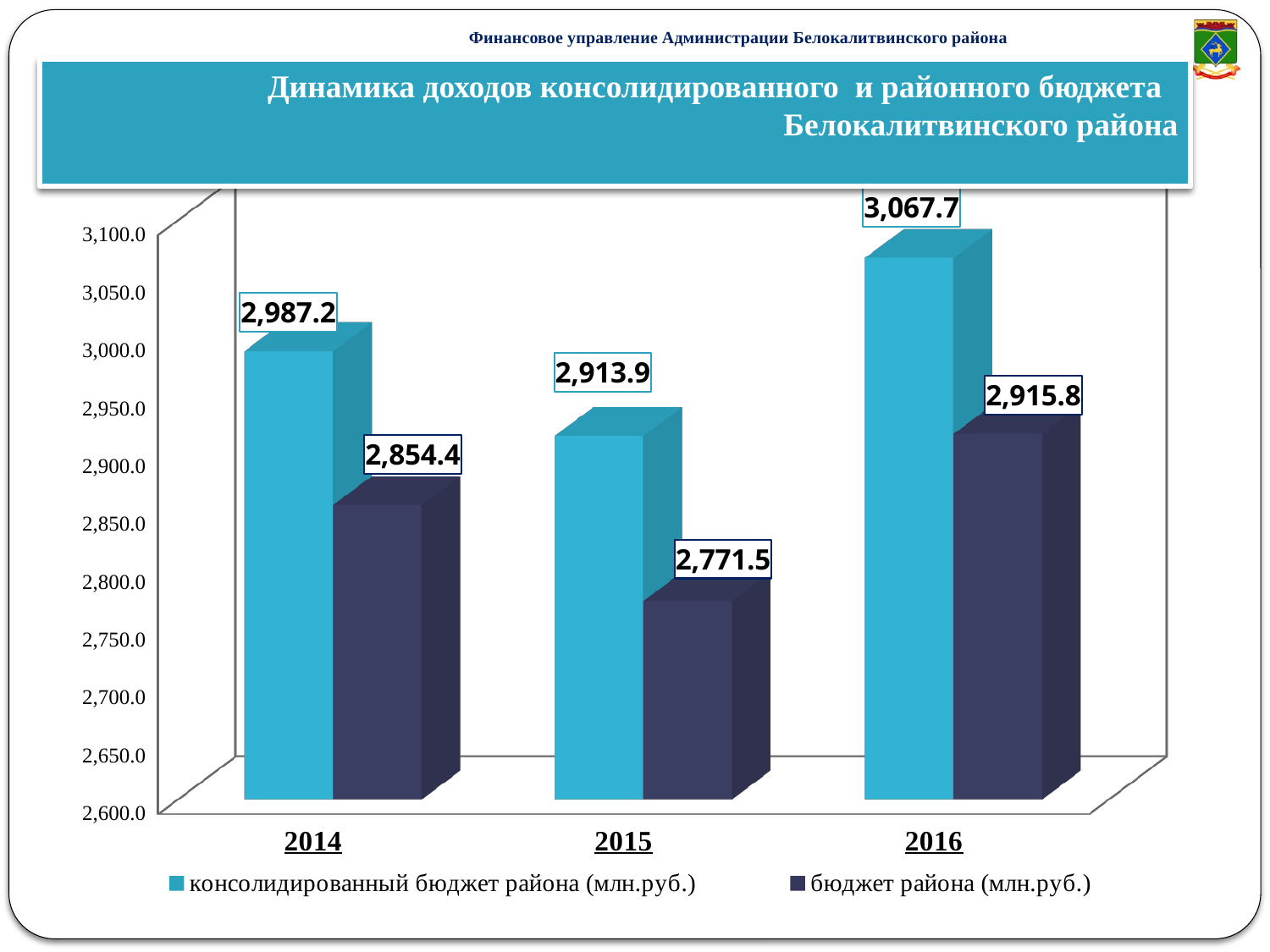
How many series does the legend list? 2 What is the value of the консолидированный бюджет района (млн.руб.) series for 2016? 3,067.7 In which year is the консолидированный бюджет района (млн.руб.) value the highest? 2016 What is the difference between the консолидированный бюджет района and бюджет района values for 2016? 151.9 What is the value of the бюджет района (млн.руб.) series for 2014? 2,854.4 Does the бюджет района (млн.руб.) value rise or fall from 2015 to 2016? rise What kind of chart is shown on the slide? bar chart What is the value of the бюджет района (млн.руб.) series for 2015? 2,771.5 How many years are shown on the x axis of the chart? 3 By how much did the консолидированный бюджет района value change from 2014 to 2016? 80.5 In which year is the бюджет района (млн.руб.) value the lowest? 2015 Which is larger: the консолидированный бюджет района value for 2015 or the бюджет района value for 2016? бюджет района value for 2016